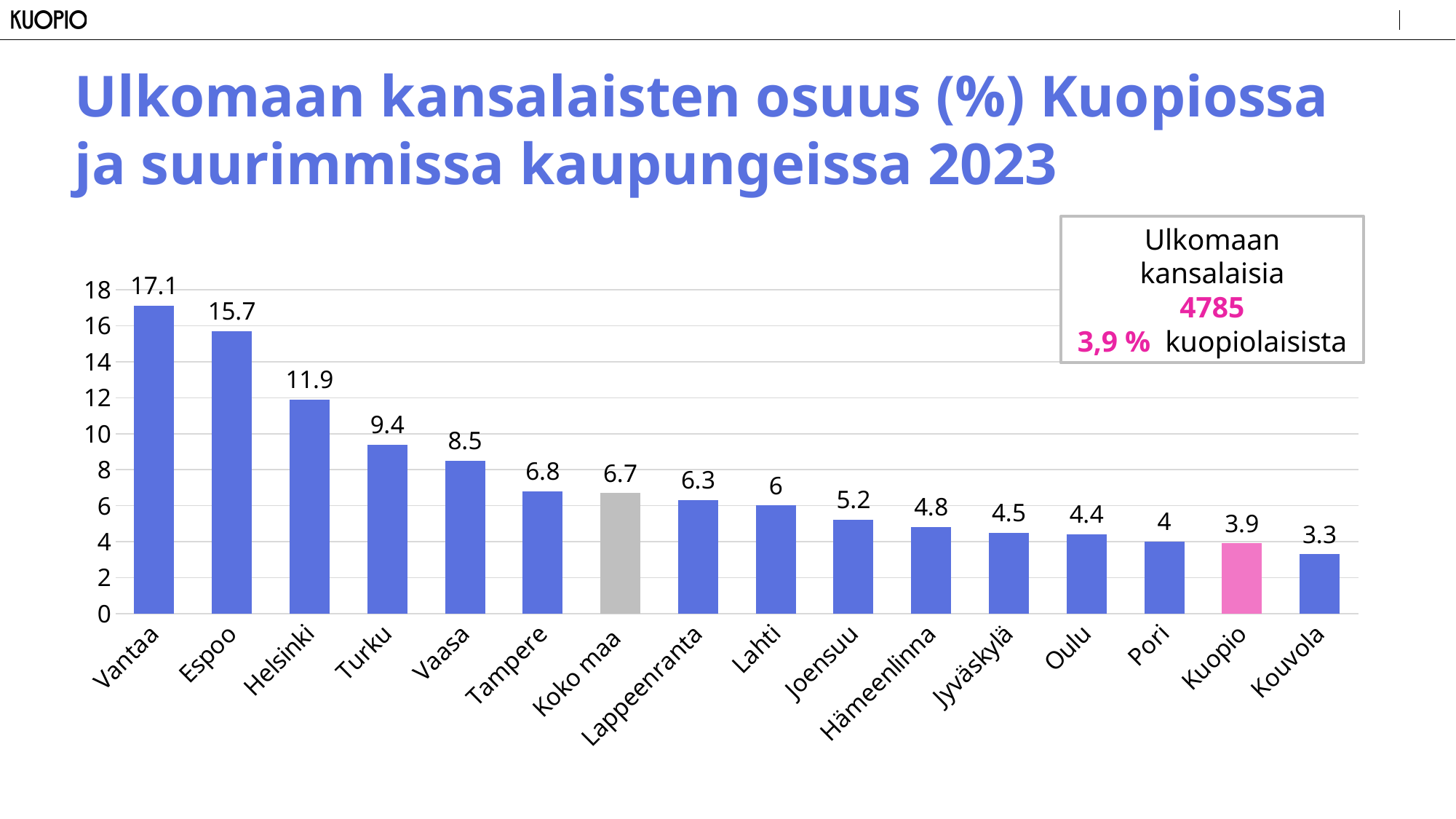
Is the value for Lahti greater or less than 4? greater How many categories are shown on the x axis? 16 What is the difference between the values for Koko maa and Kuopio? 2.8 What kind of chart is shown on the slide? bar chart What is the difference between the values for Vantaa and Espoo? 1.4 Which is larger, the value for Turku or the value for Vaasa? Turku What is the value for Kuopio? 3.9 What is the value for Koko maa? 6.7 Which category has the lowest value? Kouvola Which bar is coloured pink? Kuopio Which category has the highest value? Vantaa What is the value for Helsinki? 11.9